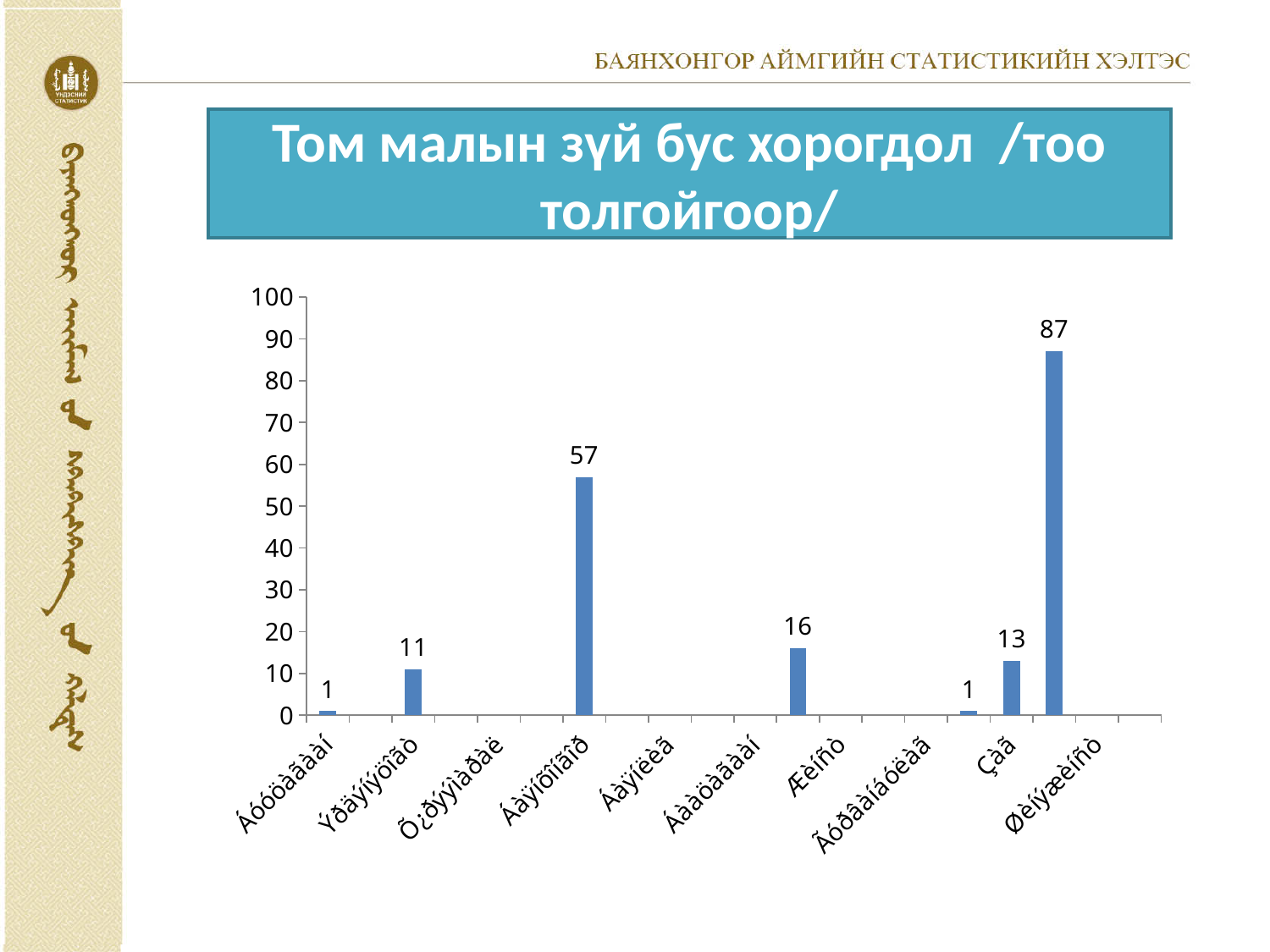
How many category labels are shown along the x axis of the chart? 10 How many bars in the chart have a data label of 1? 2 What is the highest value shown by any bar in the chart? 87 What is the title of the chart on the slide? Том малын зүй бус хорогдол /тоо толгойгоор/ Is the value of the tallest bar greater or less than 80? greater What kind of chart is shown on the slide? bar chart What is the value of the leftmost bar in the chart? 1 What is the second-highest value shown by a bar in the chart? 57 What is the difference between the bar labelled 16 and the bar labelled 13? 3 What is the difference between the highest bar (87) and the second-highest bar (57)? 30 What is the maximum value shown on the y axis of the chart? 100 What is the value of the rightmost bar in the chart? 87